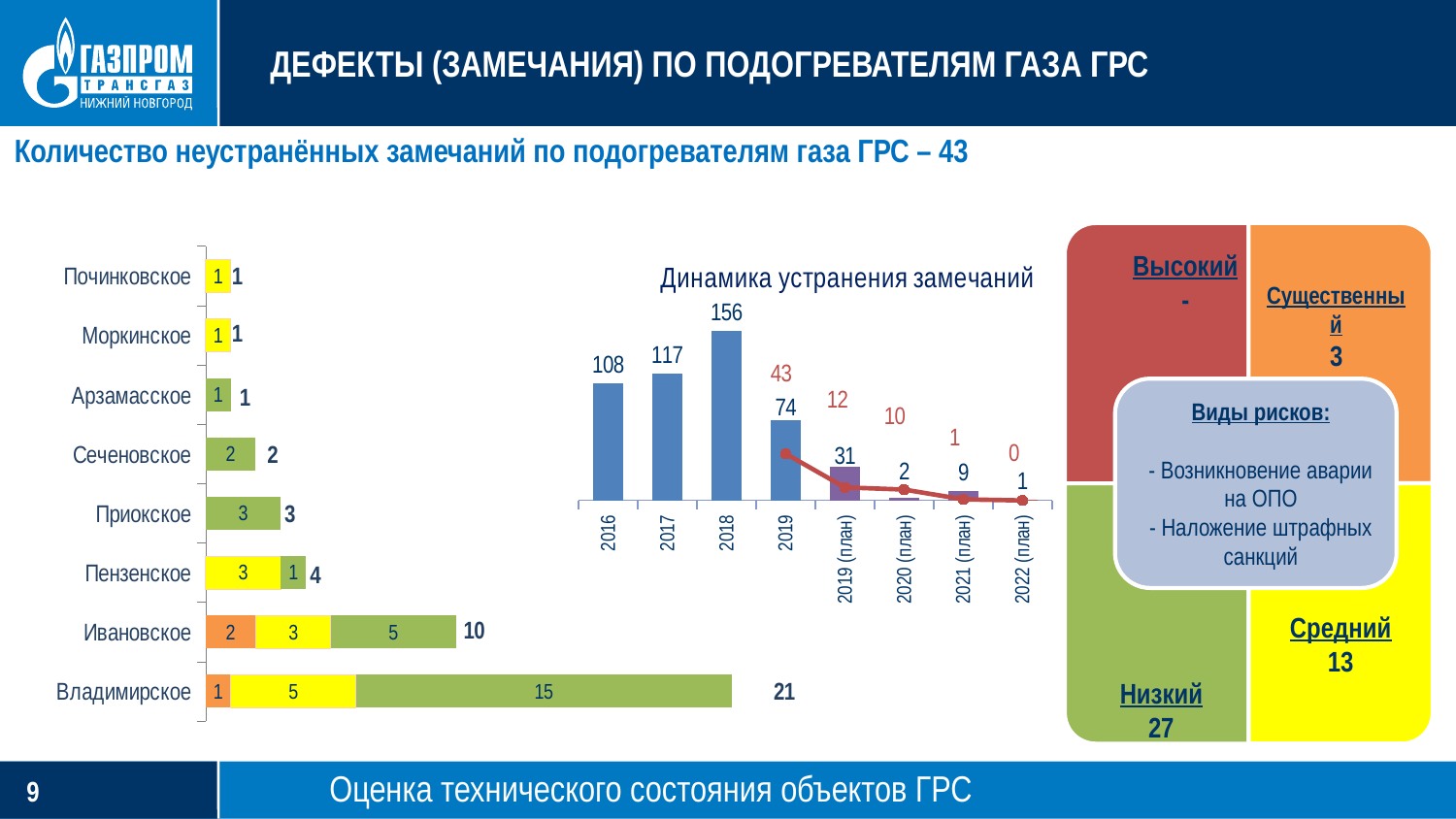
In the chart 'Динамика устранения замечаний', do the line values rise or fall from 2019 to 2022 (план)? fall On the left chart, how many categories (branches) are shown? 8 On the left chart, what is the difference between the totals for Владимирское and Ивановское? 11 On the left chart, what is the total number of unresolved remarks for Владимирское? 21 In the chart 'Динамика устранения замечаний', which year has the highest bar value? 2018 On the left chart, what is the largest segment value in the Владимирское bar? 15 In the chart 'Динамика устранения замечаний', what is the bar value for 2018? 156 On the left chart, which is larger: the total for Пензенское or the total for Приокское? Пензенское In the chart 'Динамика устранения замечаний', what is the line value for 2019? 43 On the left chart, what is the total for Ивановское? 10 In the chart 'Динамика устранения замечаний', what is the difference between the bar values for 2018 and 2017? 39 On the left chart, which category has the highest total? Владимирское